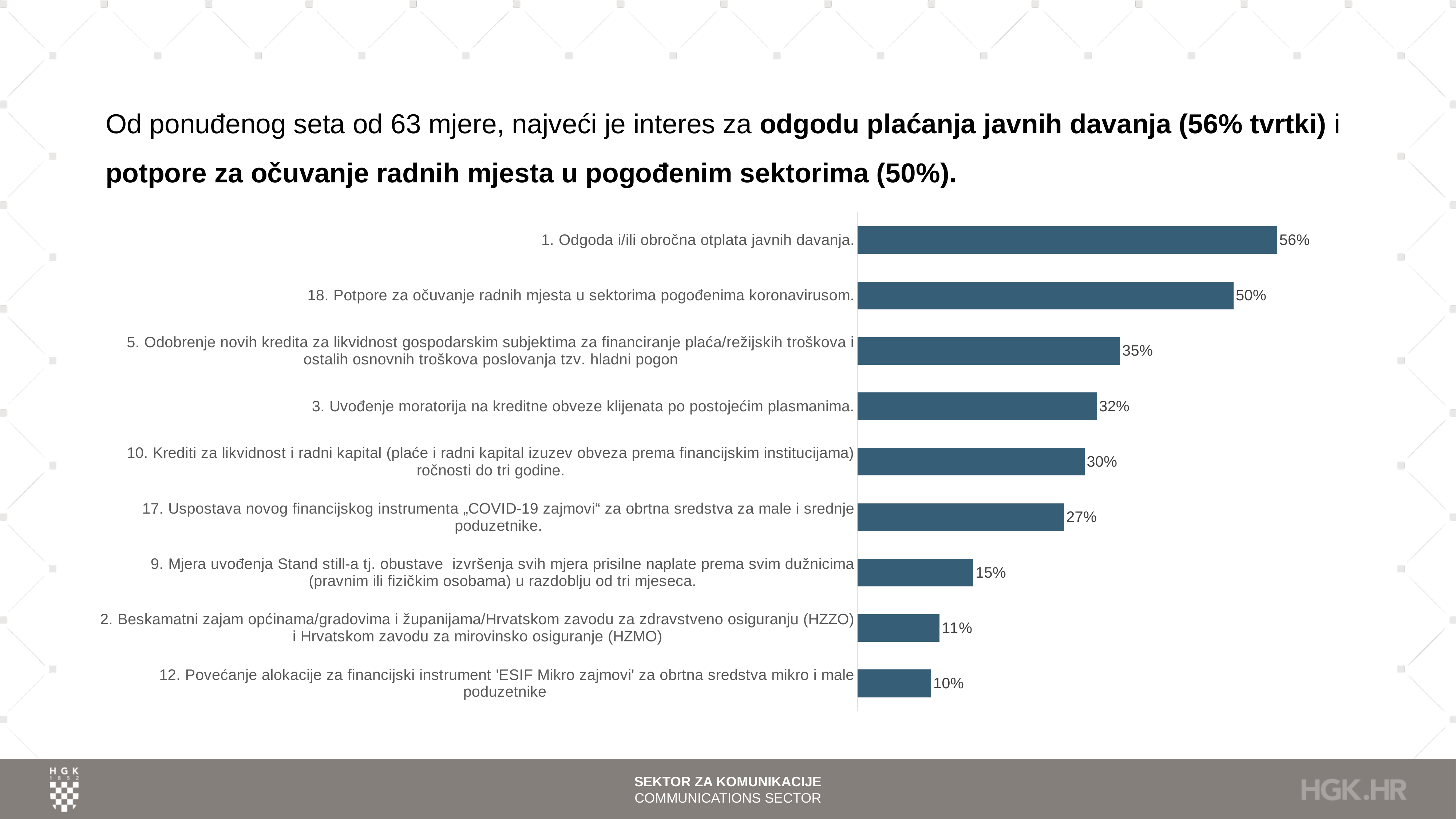
What is the value for "1. Odgoda i/ili obročna otplata javnih davanja."? 56% What is the difference between the values for measure 1 (Odgoda i/ili obročna otplata javnih davanja) and measure 18 (Potpore za očuvanje radnih mjesta)? 6% How many categories are shown in the chart? 9 What is the value for "3. Uvođenje moratorija na kreditne obveze klijenata po postojećim plasmanima."? 32% Which category has the highest value? 1. Odgoda i/ili obročna otplata javnih davanja. Which has a larger value: measure 10 (Krediti za likvidnost i radni kapital) or measure 17 (Uspostava novog financijskog instrumenta „COVID-19 zajmovi“)? 10. Krediti za likvidnost i radni kapital What colour are the bars in the chart? Dark blue What is the value for "18. Potpore za očuvanje radnih mjesta u sektorima pogođenima koronavirusom."? 50% What is the difference between the values for measure 5 (Odobrenje novih kredita za likvidnost) and measure 9 (Mjera uvođenja Stand still-a)? 20% What is the value for "12. Povećanje alokacije za financijski instrument 'ESIF Mikro zajmovi' za obrtna sredstva mikro i male poduzetnike"? 10% What kind of chart is shown on the slide? Bar chart Which category has the lowest value? 12. Povećanje alokacije za financijski instrument 'ESIF Mikro zajmovi' za obrtna sredstva mikro i male poduzetnike